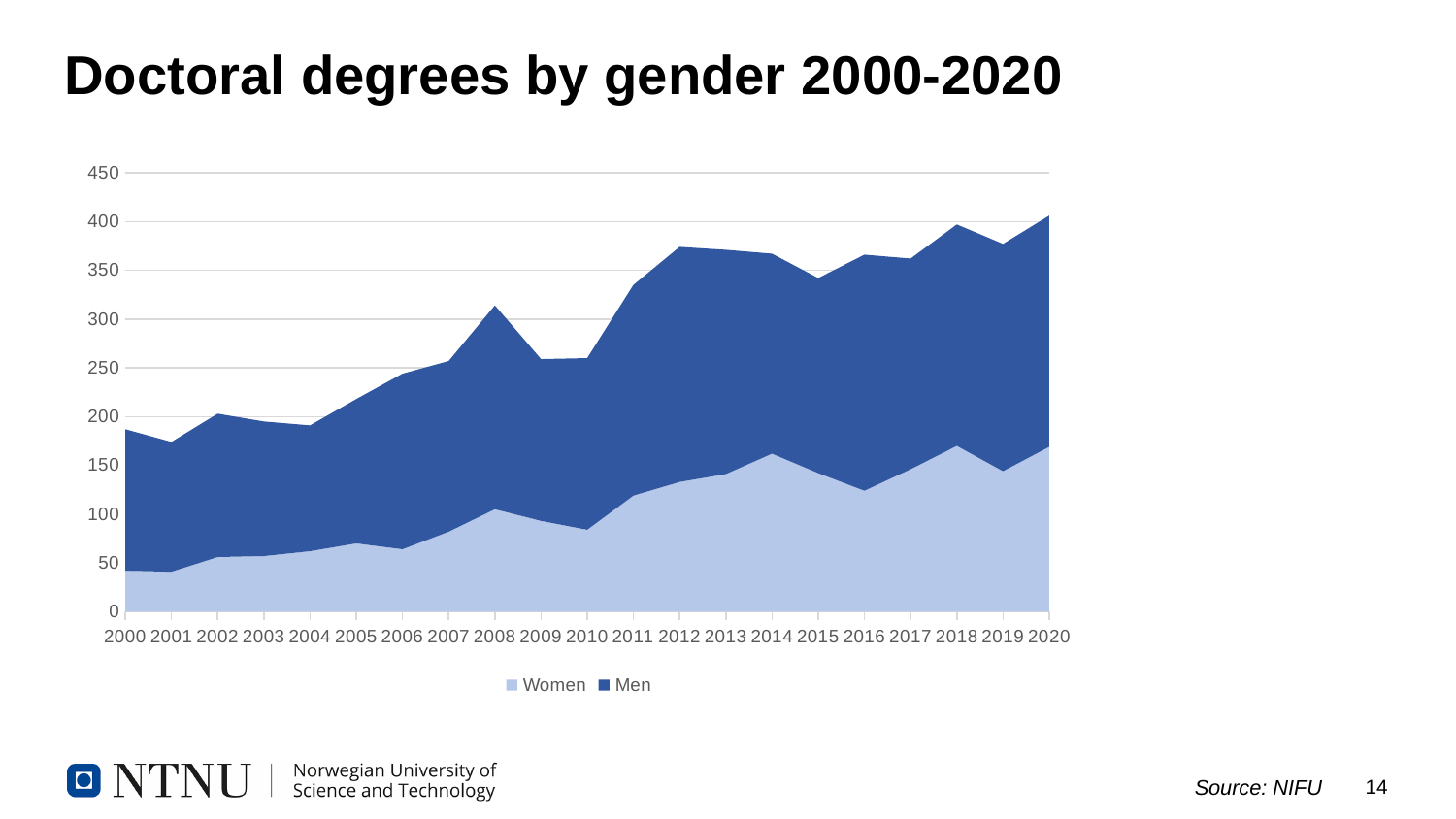
Is the value for Women in 2020 greater or less than 150? greater Which year has the highest total number of doctoral degrees? 2020 What type of chart is shown on the slide? Stacked area chart Is the total number of doctoral degrees in 2012 greater or less than 350? greater Is the value for Women in 2000 greater or less than 100? less Which series is shown in the lighter blue colour? Women How many years are shown along the x axis? 21 Overall, do the total doctoral degrees rise or fall from 2000 to 2020? Rise How many series does the legend list? 2 What is the title of the chart? Doctoral degrees by gender 2000-2020 Which year has a larger total of doctoral degrees, 2008 or 2009? 2008